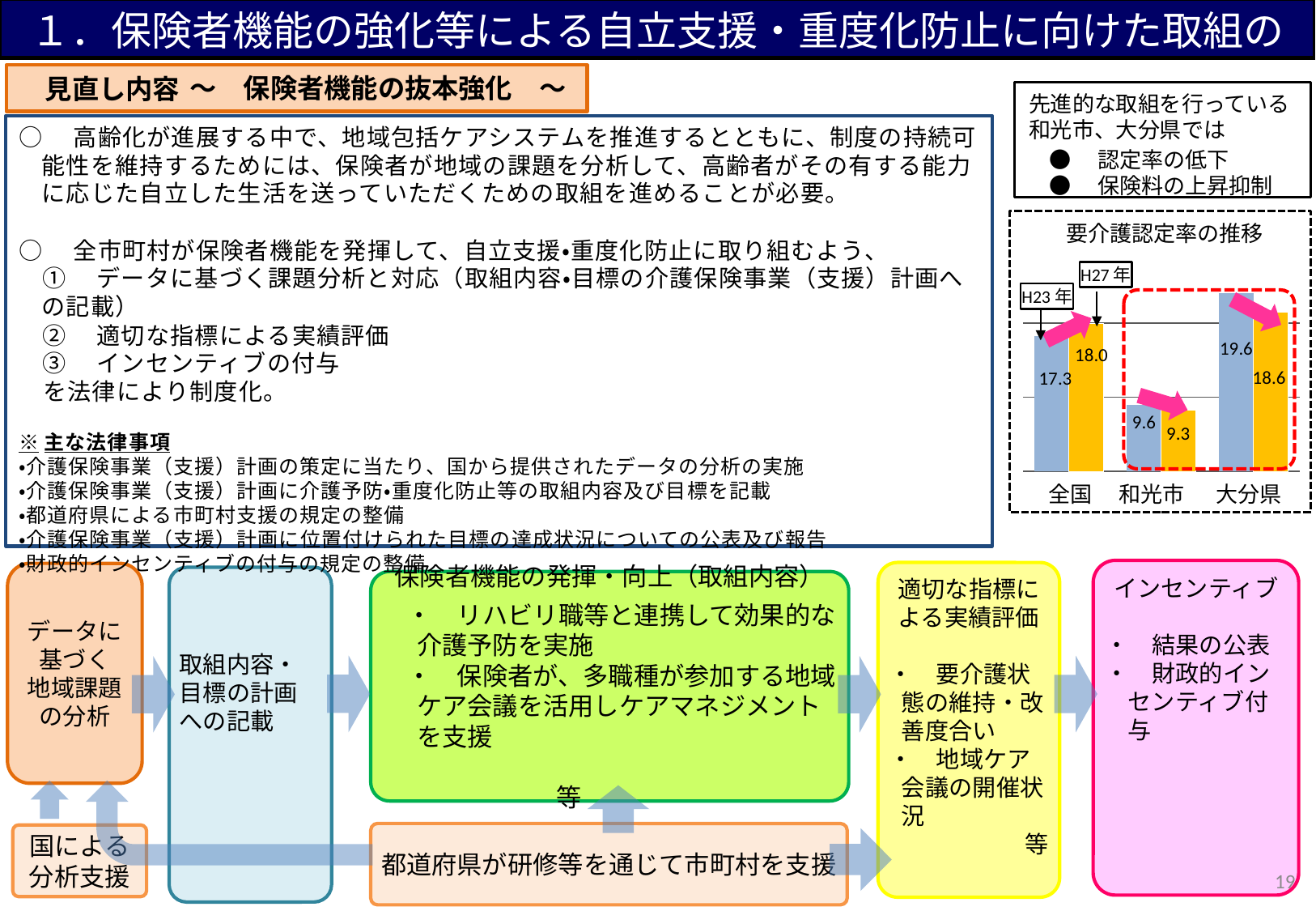
What is the title of the chart on the slide? 要介護認定率の推移 In the 要介護認定率の推移 chart, what is the difference between the H23年 and H27年 values for 大分県? 1.0 In the 要介護認定率の推移 chart, what is the H23年 value for 大分県? 19.6 What kind of chart is 要介護認定率の推移? bar chart In the 要介護認定率の推移 chart, which category has the highest H23年 value? 大分県 How many series (years) are plotted in the 要介護認定率の推移 chart? 2 In the 要介護認定率の推移 chart, which category has the lowest H27年 value? 和光市 In the 要介護認定率の推移 chart, what is the H23年 value for 全国? 17.3 In the 要介護認定率の推移 chart, what is the H27年 value for 和光市? 9.3 In the 要介護認定率の推移 chart, which colour represents the H27年 series? orange In the 要介護認定率の推移 chart, is the H27年 value for 全国 larger or smaller than its H23年 value? larger How many categories are shown on the x axis of the 要介護認定率の推移 chart? 3